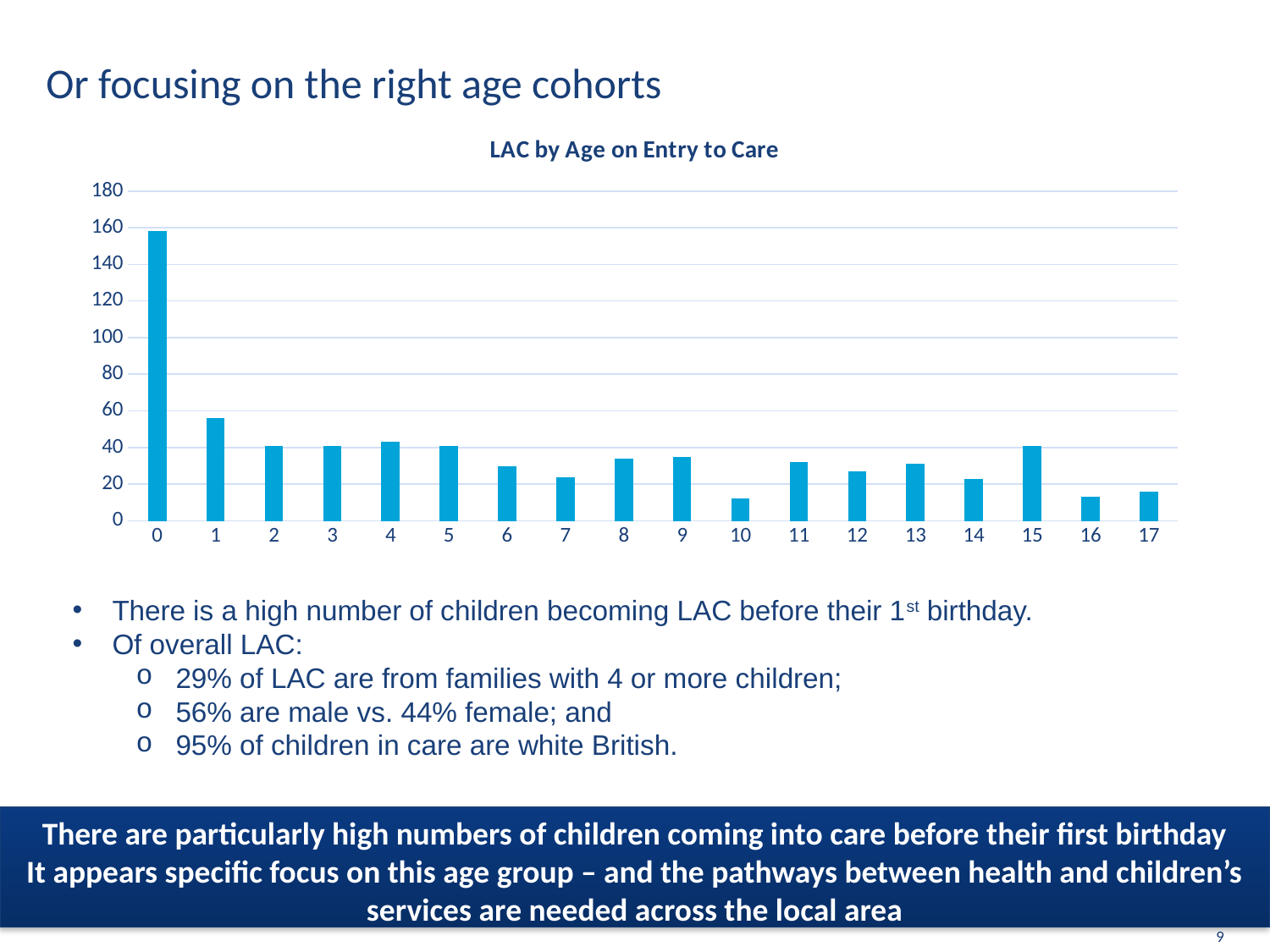
Is the value for age 10 greater or less than 20? less Does the value rise or fall from age 0 to age 1? fall What kind of chart is shown on the slide? bar chart What is the title of the chart? LAC by Age on Entry to Care Is the value for age 17 greater or less than 20? less How many age categories are shown on the x axis of the chart? 18 Which has a higher value, age 7 or age 10? age 7 Is the value for age 9 greater or less than 40? less Which age has the highest number of LAC on entry to care? 0 Which has a higher value, age 1 or age 2? age 1